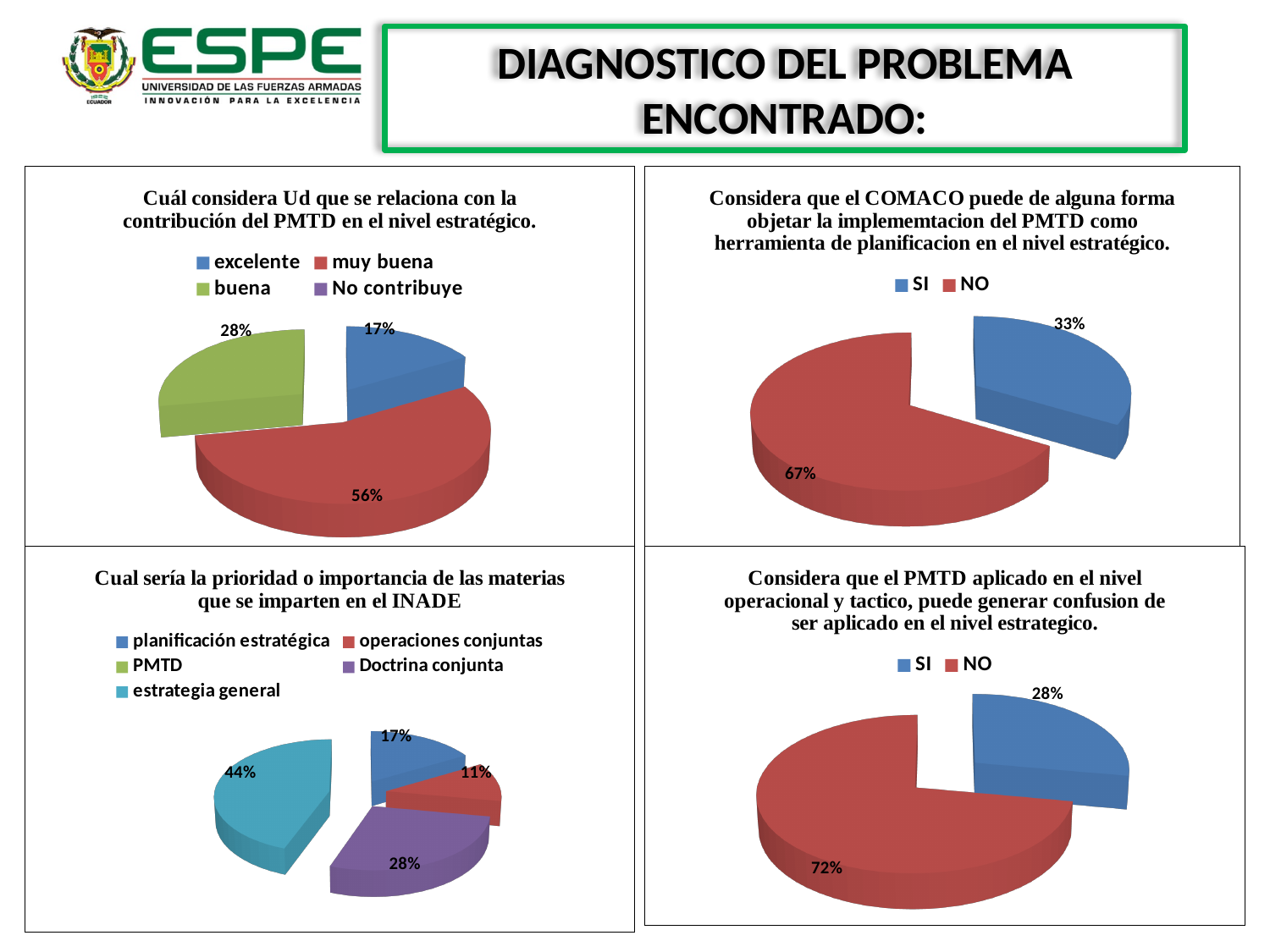
In the top-left chart (contribución del PMTD en el nivel estratégico), what percentage corresponds to 'excelente'? 17% In the top-left chart (contribución del PMTD en el nivel estratégico), how many entries does the legend list? 4 In the bottom-right chart (PMTD en el nivel operacional y táctico puede generar confusión), what percentage answered 'SI'? 28% In the top-right chart (COMACO puede objetar la implementación del PMTD), what is the difference between the 'NO' and 'SI' shares? 34% In the bottom-left chart (prioridad de las materias que se imparten en el INADE), what percentage corresponds to 'estrategia general'? 44% In the top-right chart (COMACO puede objetar la implementación del PMTD), what percentage answered 'NO'? 67% In the bottom-right chart (PMTD en el nivel operacional y táctico puede generar confusión), which answer has the larger share? NO What kind of chart is used in the top-right panel (COMACO puede objetar la implementación del PMTD)? Pie chart In the bottom-left chart (prioridad de las materias que se imparten en el INADE), what percentage corresponds to 'Doctrina conjunta'? 28% In the top-left chart (contribución del PMTD en el nivel estratégico), what percentage corresponds to 'muy buena'? 56% In the bottom-left chart (prioridad de las materias que se imparten en el INADE), which is larger: 'planificación estratégica' or 'operaciones conjuntas'? planificación estratégica In the top-left chart (contribución del PMTD en el nivel estratégico), which category has the largest share? muy buena